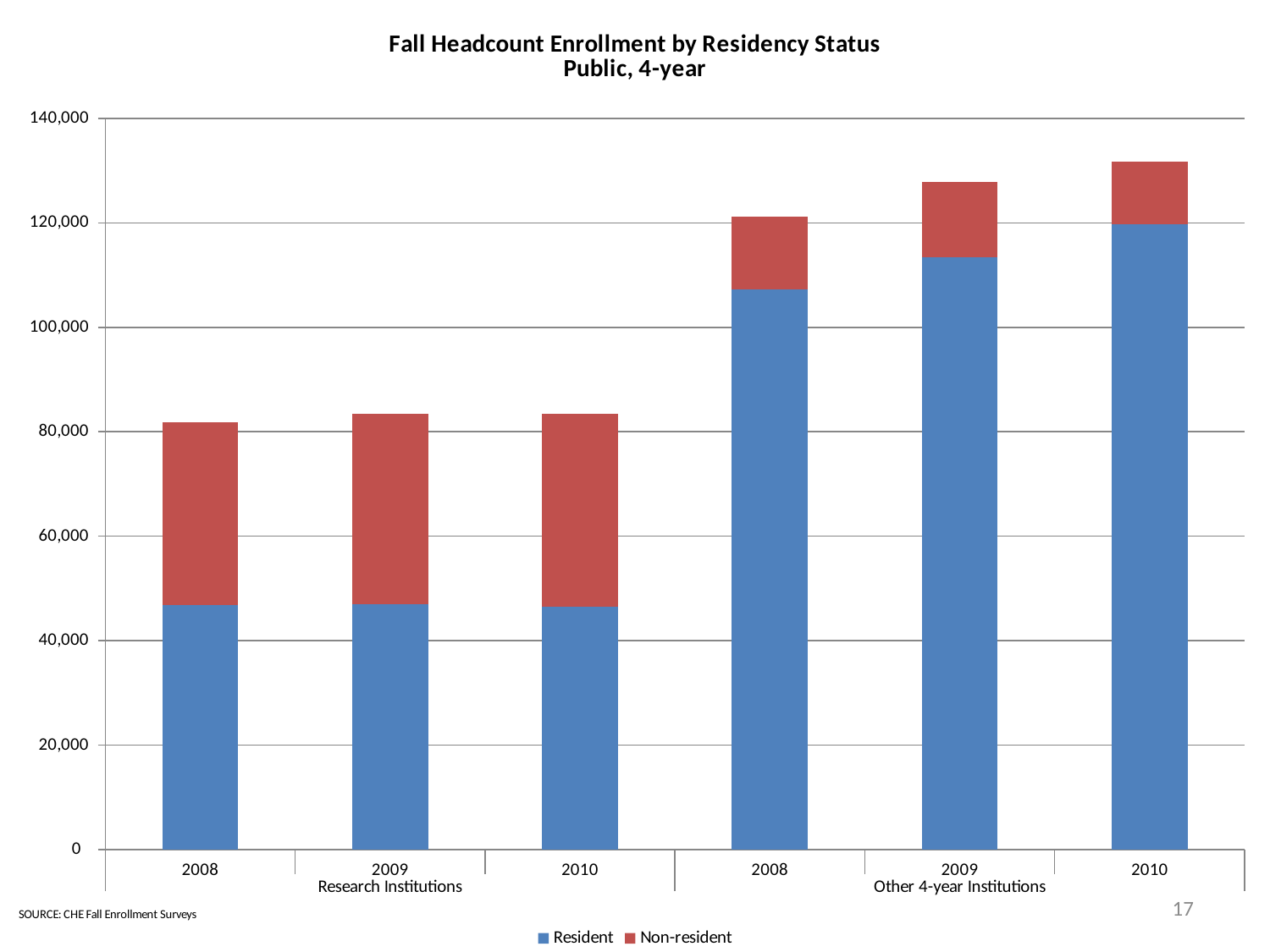
Is the total enrollment for Other 4-year Institutions in 2010 greater or less than 120,000? greater What kind of chart is shown on the slide? bar chart Which colour represents the Non-resident series in the legend? red How many series does the legend list? 2 Which is larger: the total enrollment for Other 4-year Institutions in 2008 or for Research Institutions in 2010? Other 4-year Institutions in 2008 How many bars are plotted in the chart? 6 Which bar has the highest total enrollment? 2010, Other 4-year Institutions Do the total enrollments for Other 4-year Institutions rise or fall from 2008 to 2010? rise Is the Resident enrollment for Other 4-year Institutions in 2008 greater or less than 100,000? greater Which bar has the lowest total enrollment? 2008, Research Institutions Is the Resident enrollment for Research Institutions in 2009 greater or less than 60,000? less